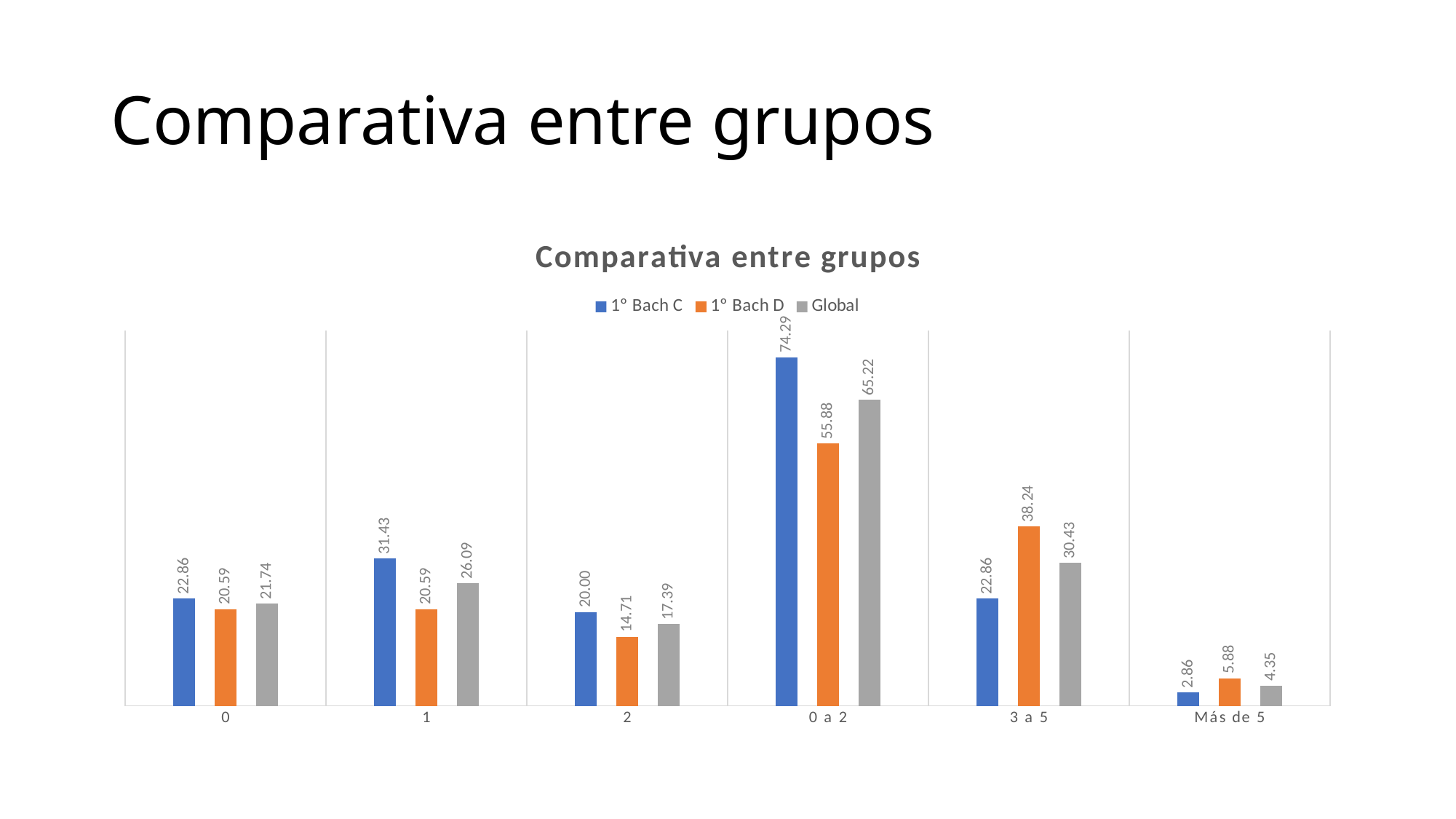
Which category has the highest value for the Global series? 0 a 2 In the "3 a 5" category, which series has the larger value, 1° Bach C or 1° Bach D? 1° Bach D Which category has the lowest value for 1° Bach C? Más de 5 What kind of chart is shown on the slide? Bar chart What is the difference between 1° Bach C and 1° Bach D in the "0 a 2" category? 18.41 Which colour represents the Global series in the chart? Grey What is the title of the chart? Comparativa entre grupos How many categories are shown on the x axis? 6 What is the value for 1° Bach D in the "Más de 5" category? 5.88 What is the value for 1° Bach C in the "0 a 2" category? 74.29 What is the value for Global in the "3 a 5" category? 30.43 How many series does the legend list? 3